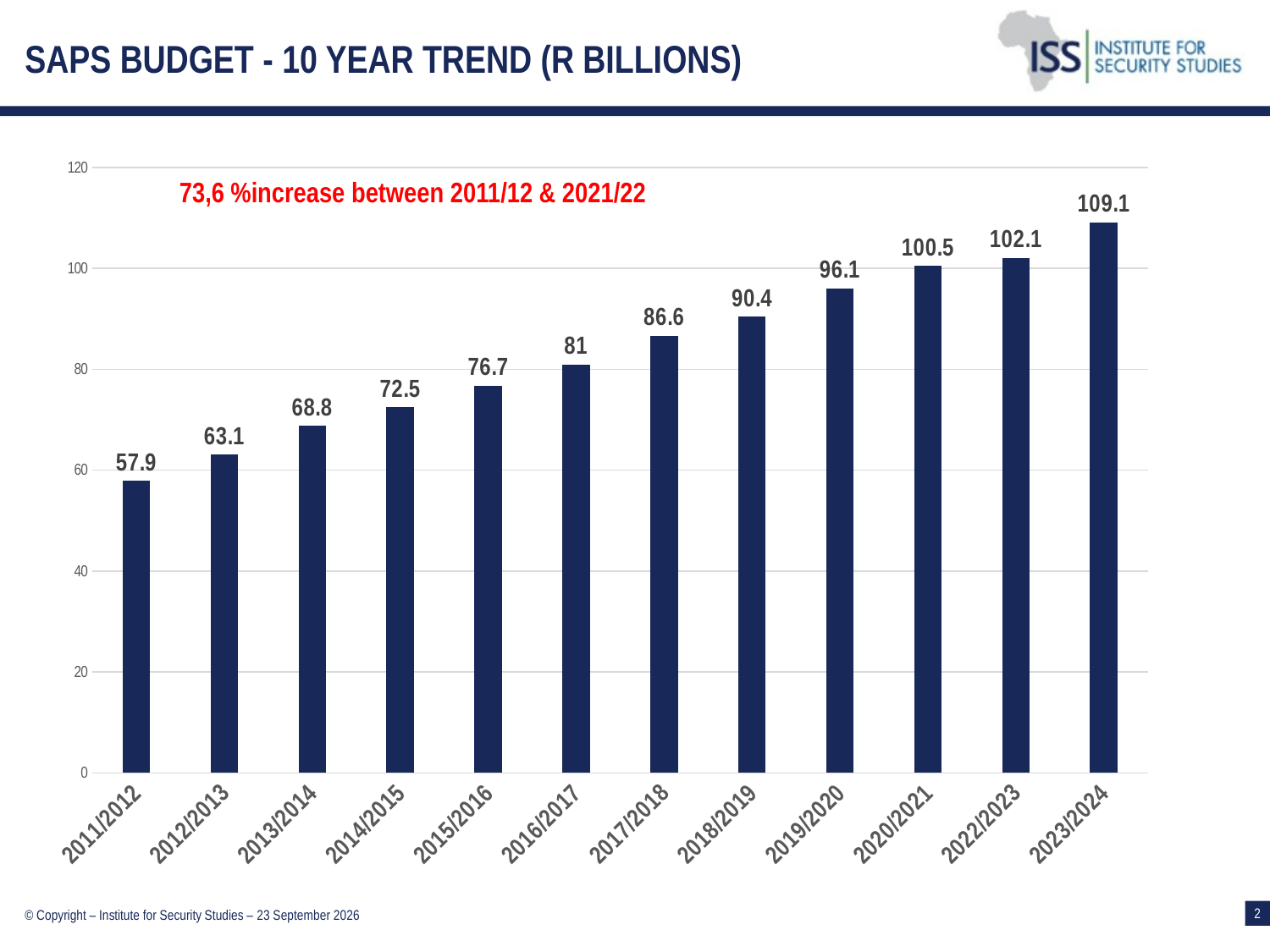
How many bars are plotted on the chart? 12 Do the values rise or fall from 2011/2012 to 2023/2024? Rise What is the value shown for 2016/2017? 81 Is the value for 2020/2021 greater or less than 100? greater What is the value shown for 2019/2020? 96.1 What is the SAPS budget value shown for 2011/2012? 57.9 Which year has the lowest value on the chart? 2011/2012 What is the difference between the values for 2018/2019 and 2017/2018? 3.8 Which is larger, the value for 2014/2015 or the value for 2015/2016? 2015/2016 What is the difference between the values for 2023/2024 and 2011/2012? 51.2 Which year has the highest value on the chart? 2023/2024 What kind of chart is shown on the slide? Bar chart